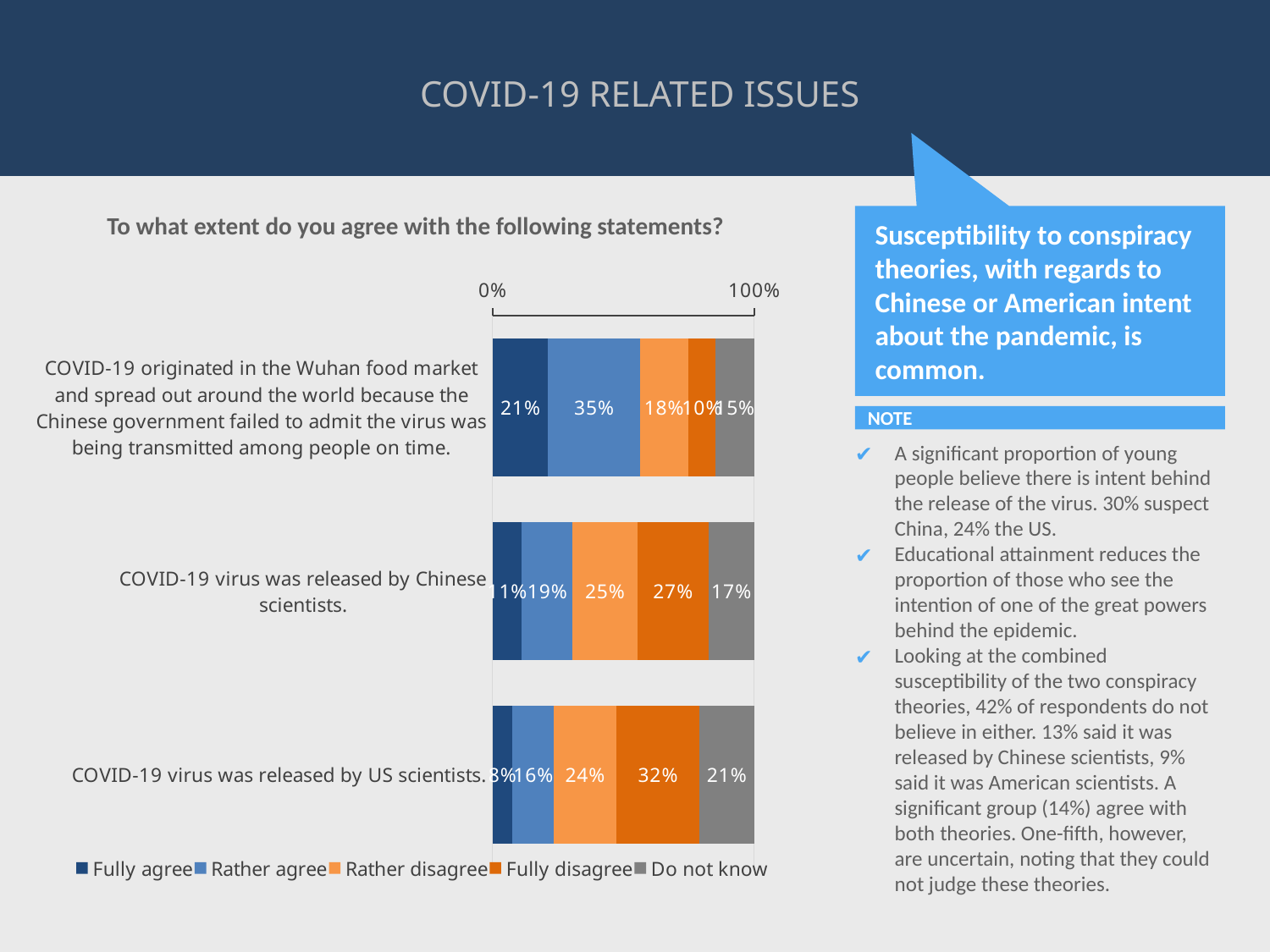
How many statements are shown in the chart? 3 What is the difference between the 'Do not know' share for the US scientists statement and the 'Do not know' share for the Chinese scientists statement? 4% What percentage of respondents answered 'Do not know' for the statement that the COVID-19 virus was released by Chinese scientists? 17% What is the first entry in the chart's legend? Fully agree What percentage of respondents 'Rather agree' that COVID-19 originated in the Wuhan food market and spread because the Chinese government failed to admit the virus was being transmitted on time? 35% What percentage of respondents 'Fully disagree' that the COVID-19 virus was released by US scientists? 32% Which statement has a larger 'Rather agree' share: the Wuhan food market statement or the statement that the virus was released by US scientists? COVID-19 originated in the Wuhan food market What percentage of respondents 'Fully agree' with the statement that COVID-19 originated in the Wuhan food market? 21% What type of chart is shown on the slide? Stacked bar chart Which statement has the highest 'Fully disagree' share? COVID-19 virus was released by US scientists. What percentage of respondents 'Rather disagree' that the COVID-19 virus was released by Chinese scientists? 25% How many response categories does the legend list? 5